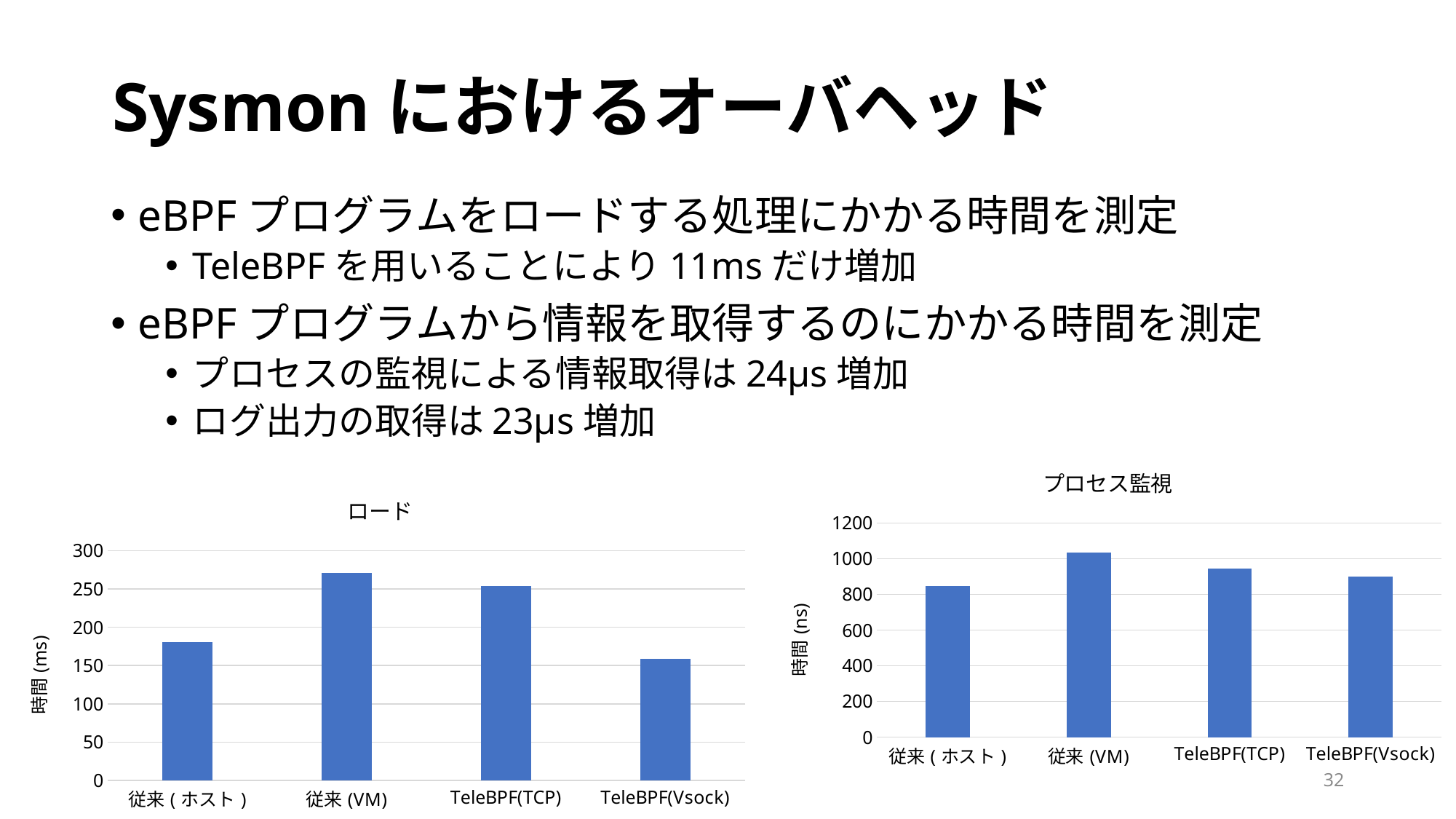
In the ロード chart, which is larger: 従来 ( ホスト ) or TeleBPF(TCP)? TeleBPF(TCP) In the プロセス監視 chart, which category has the highest value? 従来 (VM) In the ロード chart, is the value for TeleBPF(Vsock) greater or less than 200? less What kind of chart is the ロード chart on the left? bar chart In the ロード chart, which category has the highest value? 従来 (VM) In the プロセス監視 chart, is the value for 従来 (VM) greater or less than 1000? greater In the ロード chart, which category has the lowest value? TeleBPF(Vsock) In the ロード chart, is the value for 従来 (VM) greater or less than 250? greater In the プロセス監視 chart, which category has the lowest value? 従来 ( ホスト ) How many categories are shown in the ロード chart? 4 What is the y-axis label of the プロセス監視 chart? 時間 (ns) What is the y-axis label of the ロード chart? 時間 (ms)